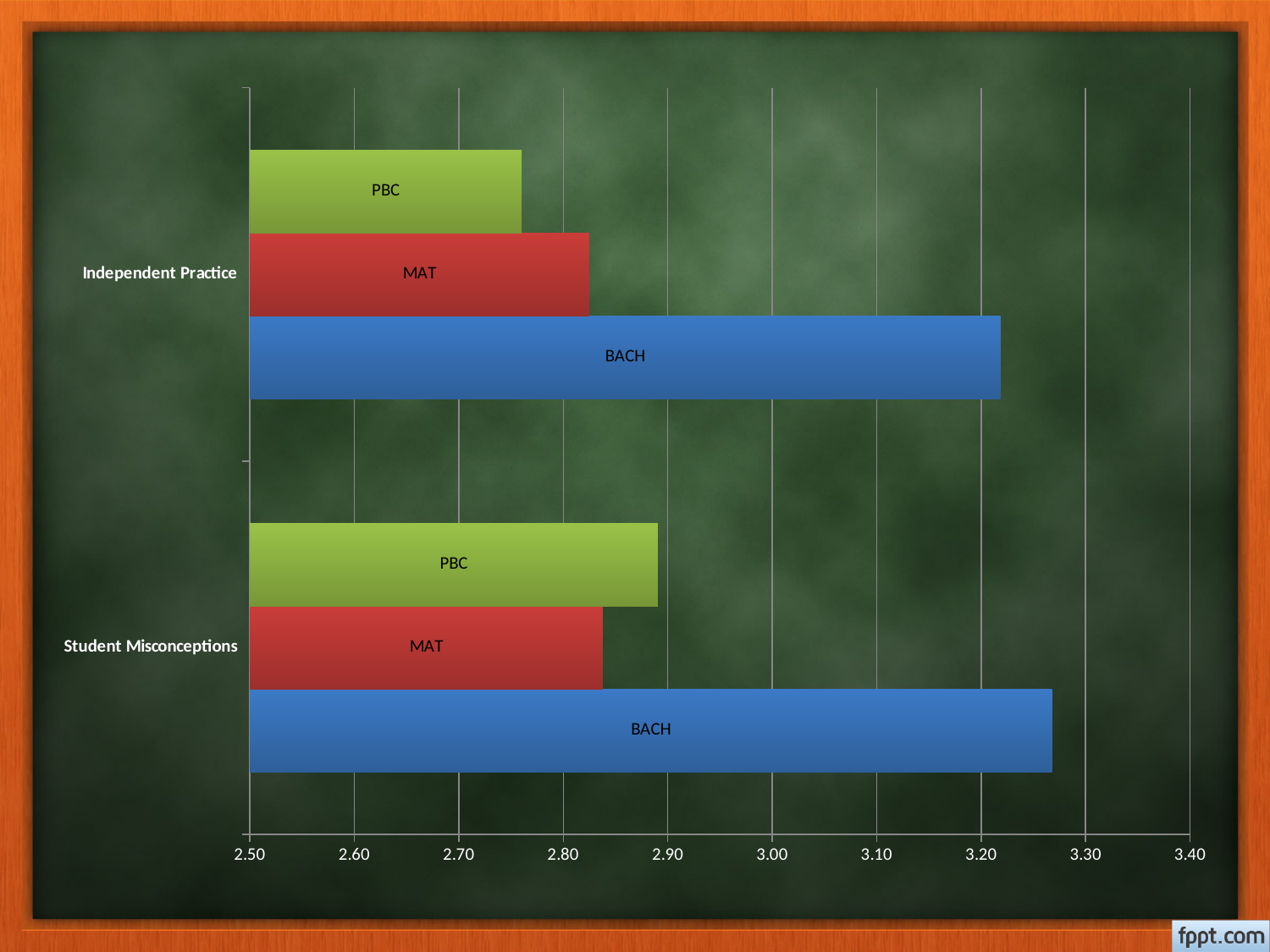
Is the value for BACH under Student Misconceptions greater or less than 3.20? greater Which is larger: the PBC value for Student Misconceptions or the PBC value for Independent Practice? Student Misconceptions Which series has the lowest value for Student Misconceptions? MAT Is the value for PBC under Independent Practice greater or less than 2.80? less What kind of chart is shown on the slide? bar chart Which series has the highest value for Independent Practice? BACH Which series has the highest value for Student Misconceptions? BACH Is the value for BACH under Independent Practice greater or less than 3.10? greater How many categories are shown on the vertical axis of the chart? 2 What colour are the BACH bars in the chart? blue How many series (PBC, MAT, BACH) are plotted for each category? 3 Which series has the lowest value for Independent Practice? PBC